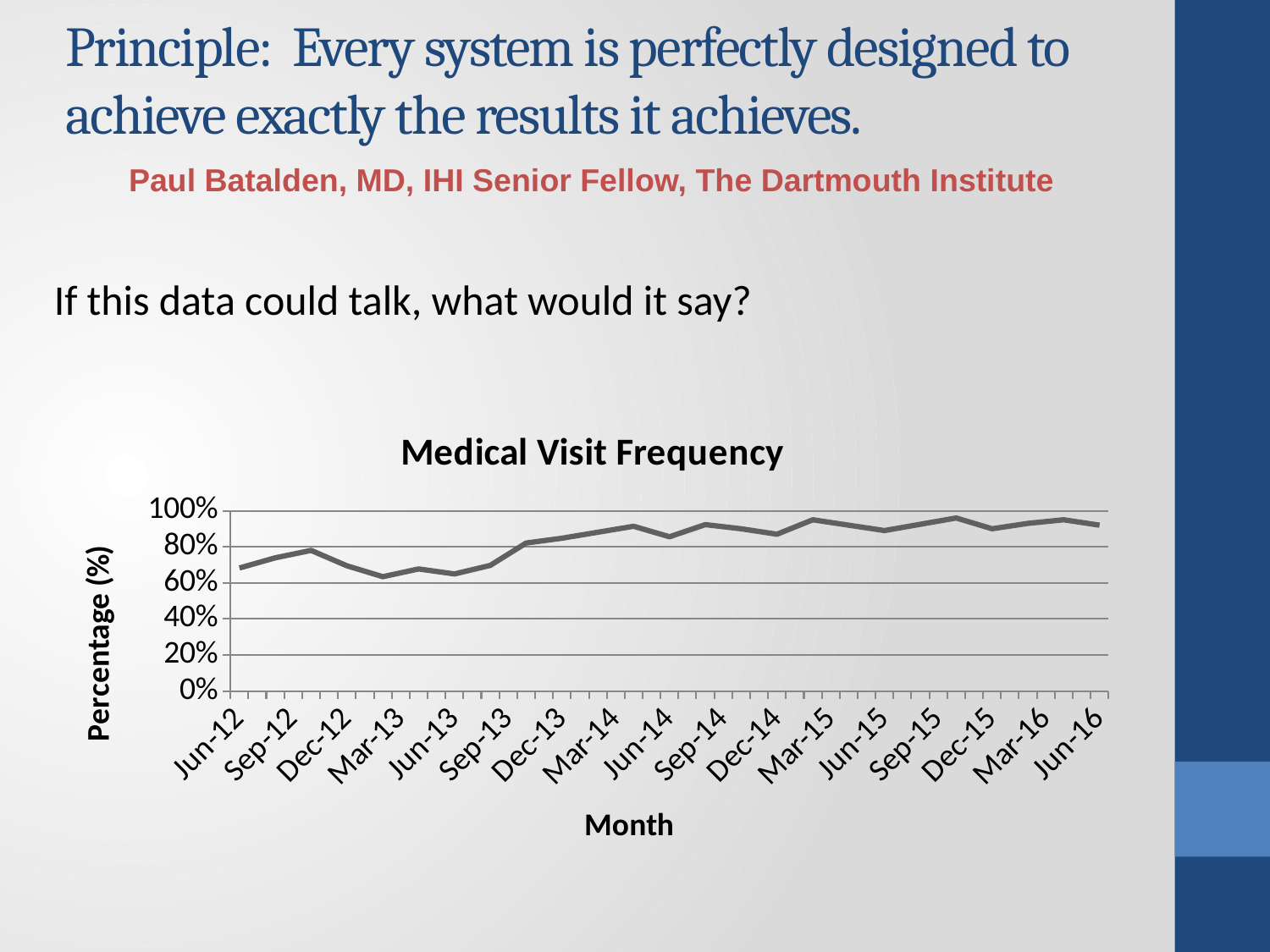
Is the value for Jun-16 greater or less than 60%? greater What is the title of the chart on the slide? Medical Visit Frequency What kind of chart is shown under the title "Medical Visit Frequency"? line chart Is the value for Dec-12 greater or less than 80%? less Overall, do the values rise or fall from Jun-12 to Jun-16? rise What is the label of the vertical axis of the chart? Percentage (%) Is the value for Dec-12 greater or less than 40%? greater